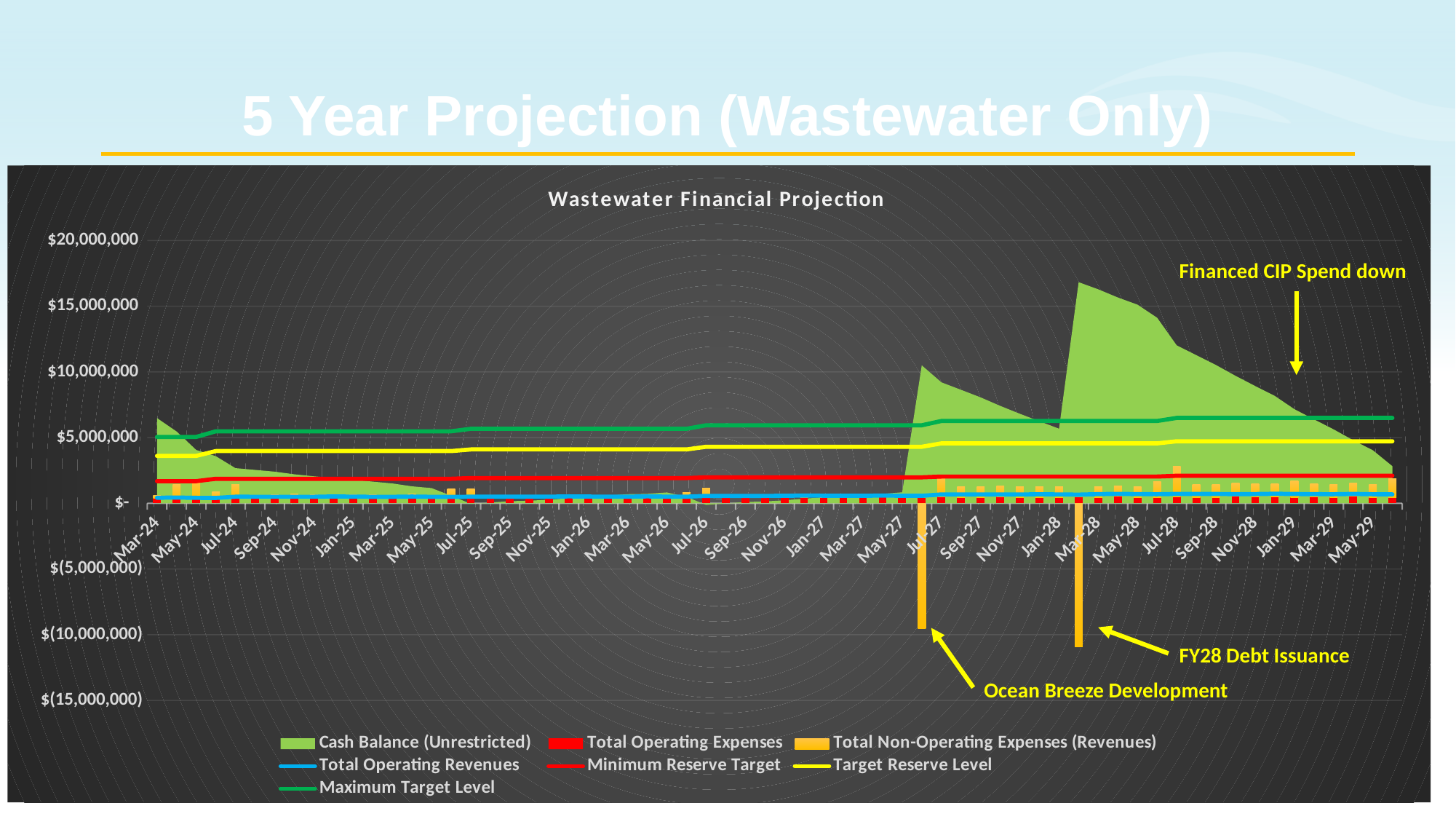
Does the Cash Balance (Unrestricted) rise or fall from Mar-28 to May-29? fall Is the Maximum Target Level at May-29 greater or less than $5,000,000? greater Is the Cash Balance (Unrestricted) higher at Mar-28 or at May-27? Mar-28 How many month labels are shown on the x axis? 32 Is the Cash Balance (Unrestricted) at Jan-26 greater or less than $5,000,000? less Is the Cash Balance (Unrestricted) at Mar-28 greater or less than $15,000,000? greater What kind of chart is this? Combination chart (area, bar and line) How many series does the chart legend list? 7 What is the title of the chart? Wastewater Financial Projection